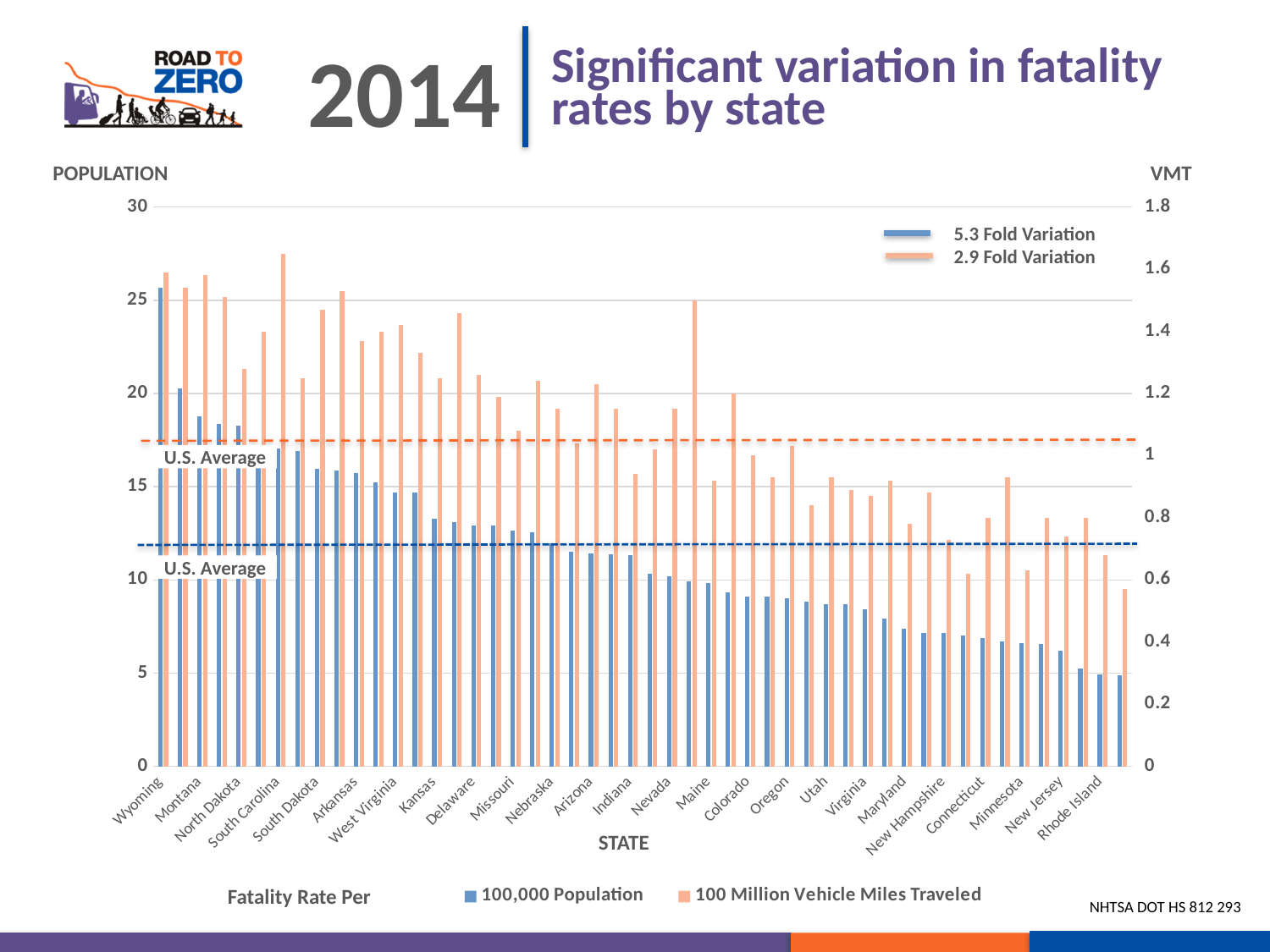
Is the fatality rate per 100,000 population for Utah greater or less than 10? less Is the fatality rate per 100,000 population for Rhode Island greater or less than 10? less How many series does the chart's legend list? 2 Is the fatality rate per 100 million vehicle miles traveled for Wyoming greater or less than 1.4? greater Which state has the larger fatality rate per 100,000 population, Kansas or New Jersey? Kansas Do the fatality rates per 100,000 population rise or fall moving from left to right along the x axis? fall Which state has the larger fatality rate per 100,000 population, Wyoming or Montana? Wyoming What is the title of the chart on the slide? Significant variation in fatality rates by state What kind of chart is shown on the slide? bar chart What fold variation is shown for the fatality rate per 100,000 population series? 5.3 Fold Variation Which state has the highest fatality rate per 100,000 population? Wyoming